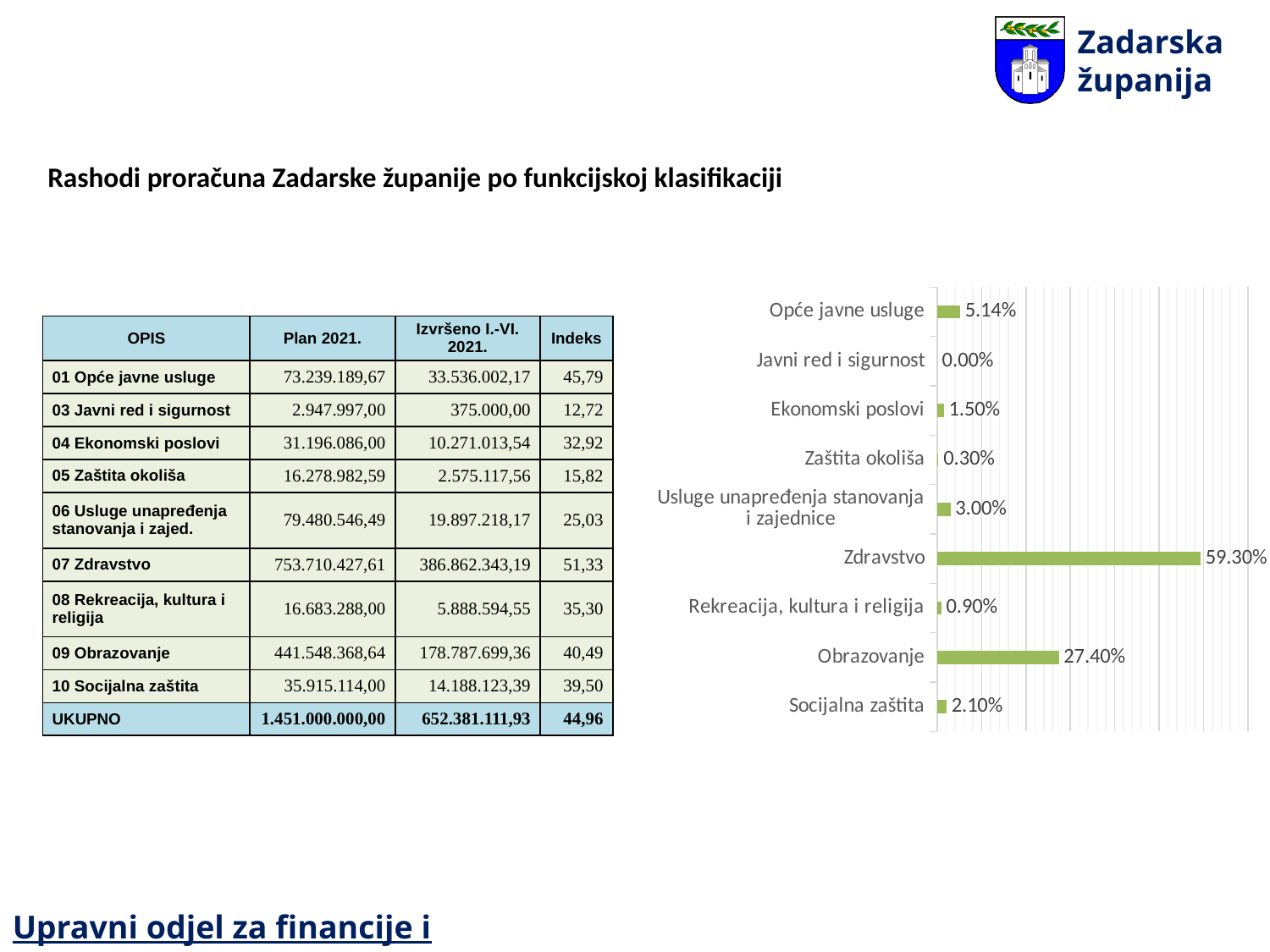
What kind of chart is shown on the slide? Bar chart How many categories are shown in the bar chart? 9 Which category has the highest value in the bar chart? Zdravstvo What is the difference between the values for Zdravstvo and Obrazovanje in the bar chart? 31.90% What is the difference between the values for Opće javne usluge and Ekonomski poslovi in the bar chart? 3.64% What is the value shown for Zdravstvo in the bar chart? 59.30% Which is larger in the bar chart, the value for Ekonomski poslovi or the value for Socijalna zaštita? Socijalna zaštita What is the value shown for Socijalna zaštita in the bar chart? 2.10% What is the value shown for Obrazovanje in the bar chart? 27.40% Which category has the lowest value in the bar chart? Javni red i sigurnost What is the value shown for Usluge unapređenja stanovanja i zajednice in the bar chart? 3.00% What is the value shown for Opće javne usluge in the bar chart? 5.14%